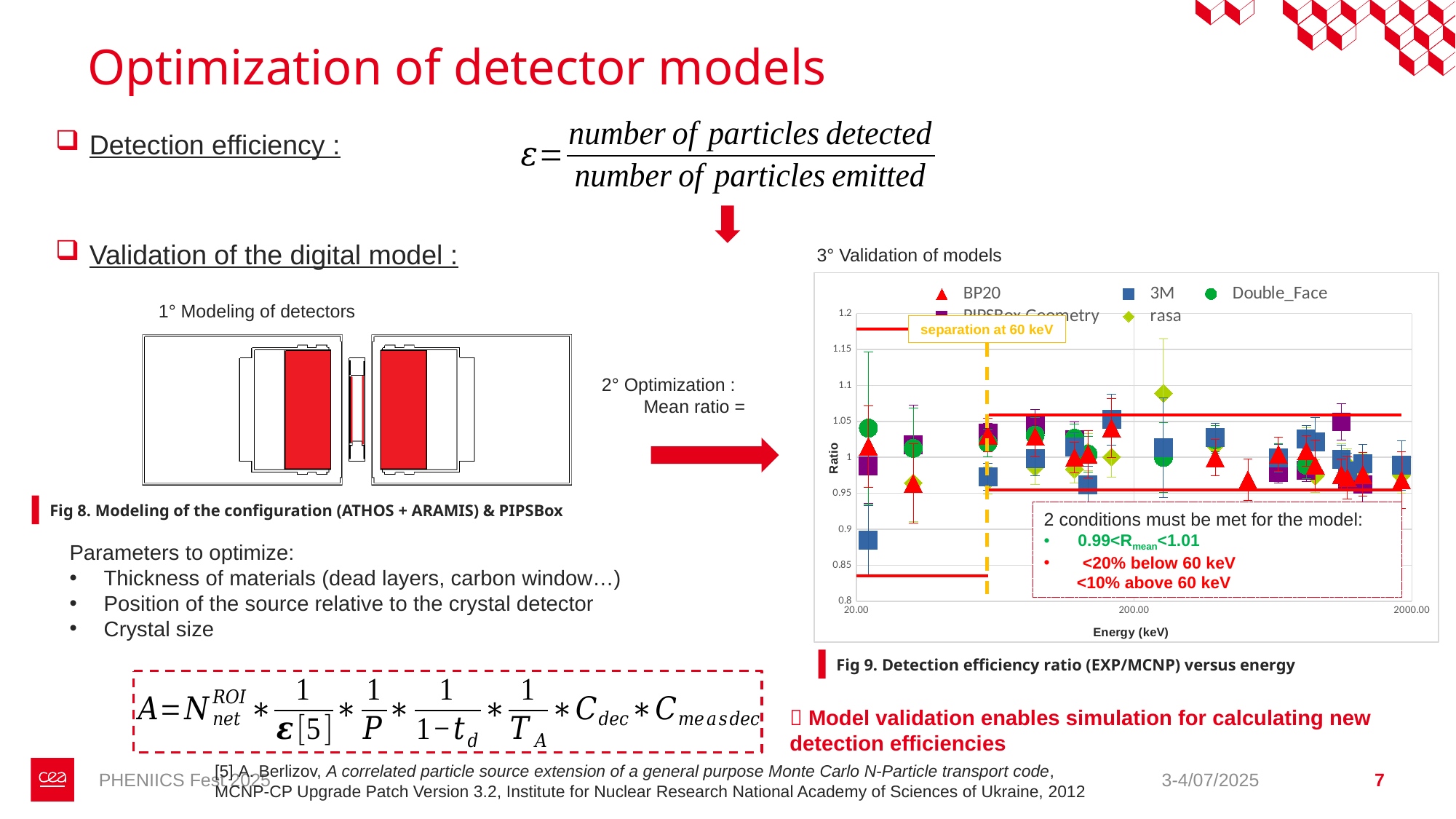
What is the title of the x axis of the Fig 9 chart? Energy (keV) What kind of chart is shown in Fig 9? scatter chart In the Fig 9 chart, is the Double_Face point near 20 keV greater or less than 1? greater Which series in the Fig 9 chart has the highest plotted ratio value? rasa In the Fig 9 chart, is the 3M point just below the 60 keV dashed line greater or less than 1? less Which series in the Fig 9 chart has the lowest plotted ratio value? 3M In the Fig 9 chart, is the lowest 3M point (near 20 keV) greater or less than 0.9? less How many series does the legend of the Fig 9 chart list? 5 What does the vertical dashed line in the Fig 9 chart mark, according to its label? separation at 60 keV